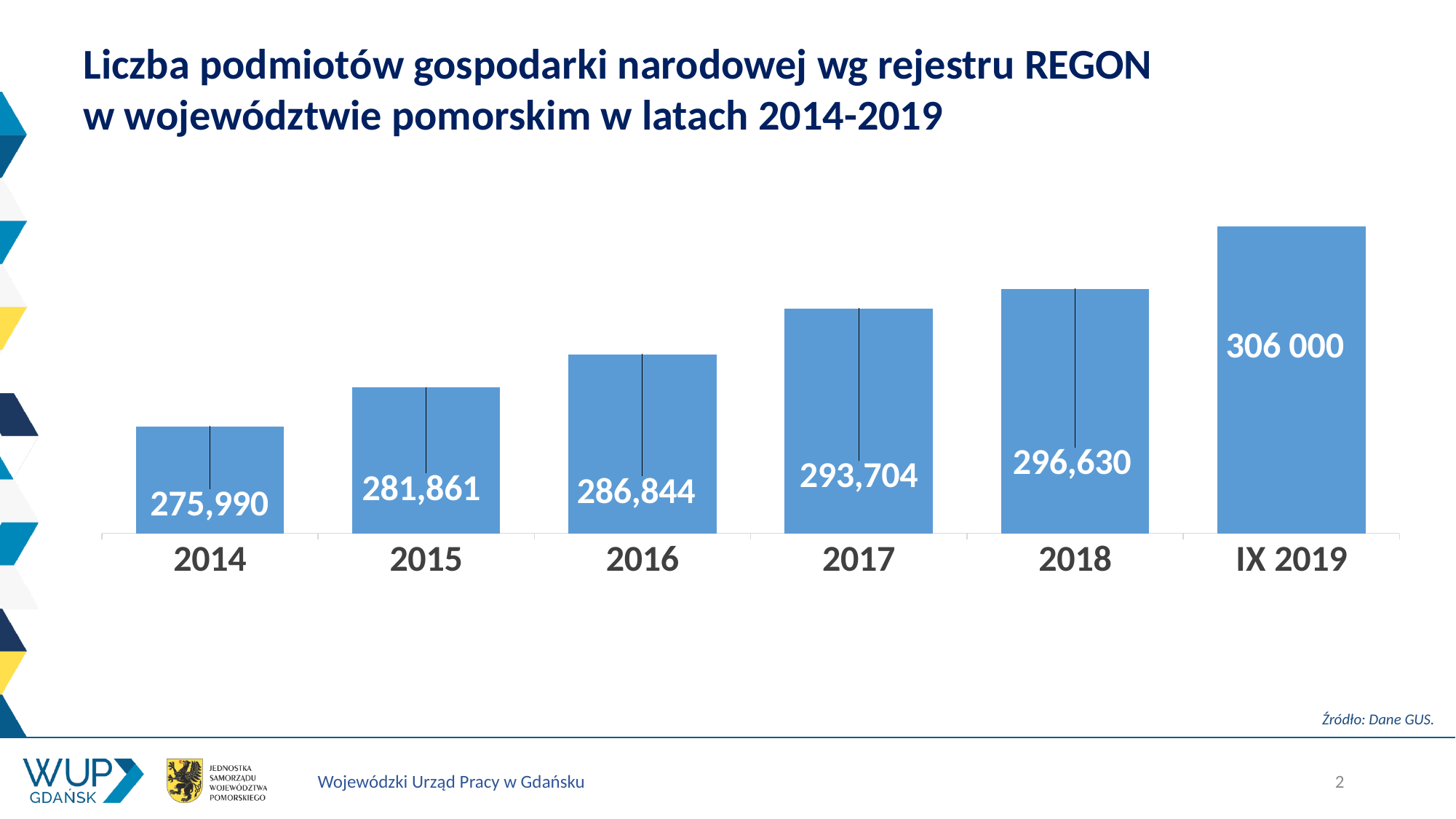
Which category has the highest value? IX 2019 Do the values rise or fall from 2014 to IX 2019? rise Which is larger, the value for 2017 or the value for 2016? 2017 How many categories are shown on the x axis? 6 What is the difference between the values for 2015 and 2014? 5,871 What is the difference between the values for 2018 and 2017? 2,926 What is the value for 2016? 286,844 What kind of chart is shown on the slide? bar chart What source is cited below the chart? Dane GUS What is the value for IX 2019? 306 000 What is the value for 2014? 275,990 Which category has the lowest value? 2014